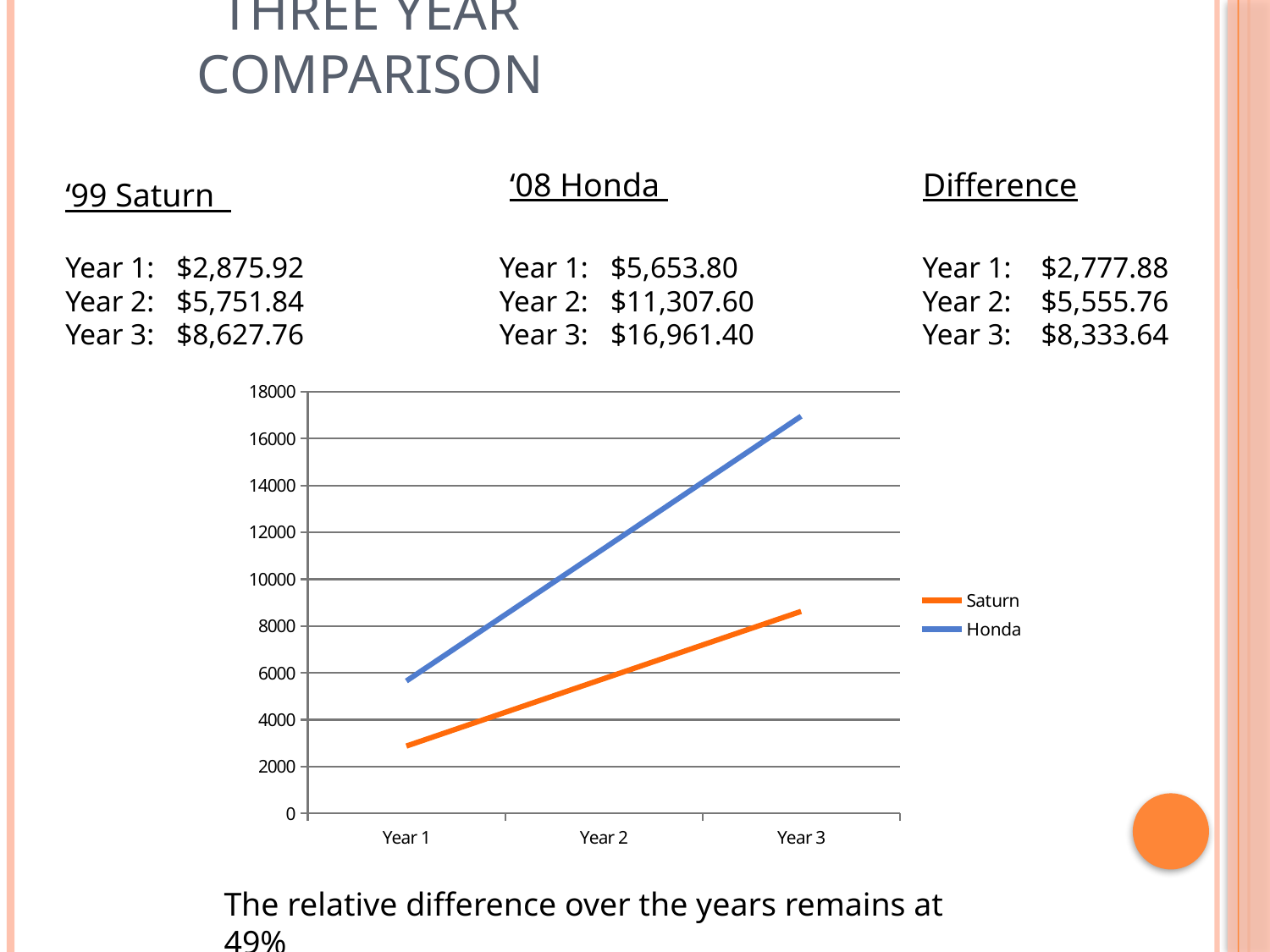
According to the slide, what is the Honda cost in Year 2? $11,307.60 According to the slide, what is the Saturn cost in Year 3? $8,627.76 According to the slide, what is the difference between Honda and Saturn in Year 1? $2,777.88 Which series is higher at Year 3, Saturn or Honda? Honda Is the Honda value at Year 1 greater or less than 4000? greater Does the Honda line rise or fall from Year 1 to Year 3? rise Is the Honda value at Year 3 greater or less than 16000? greater What kind of chart is shown on the slide? line chart How many points along the x axis does the chart have? 3 What colour is the Saturn line in the chart? orange Is the Saturn value at Year 2 greater or less than 6000? less How many series does the chart's legend list? 2